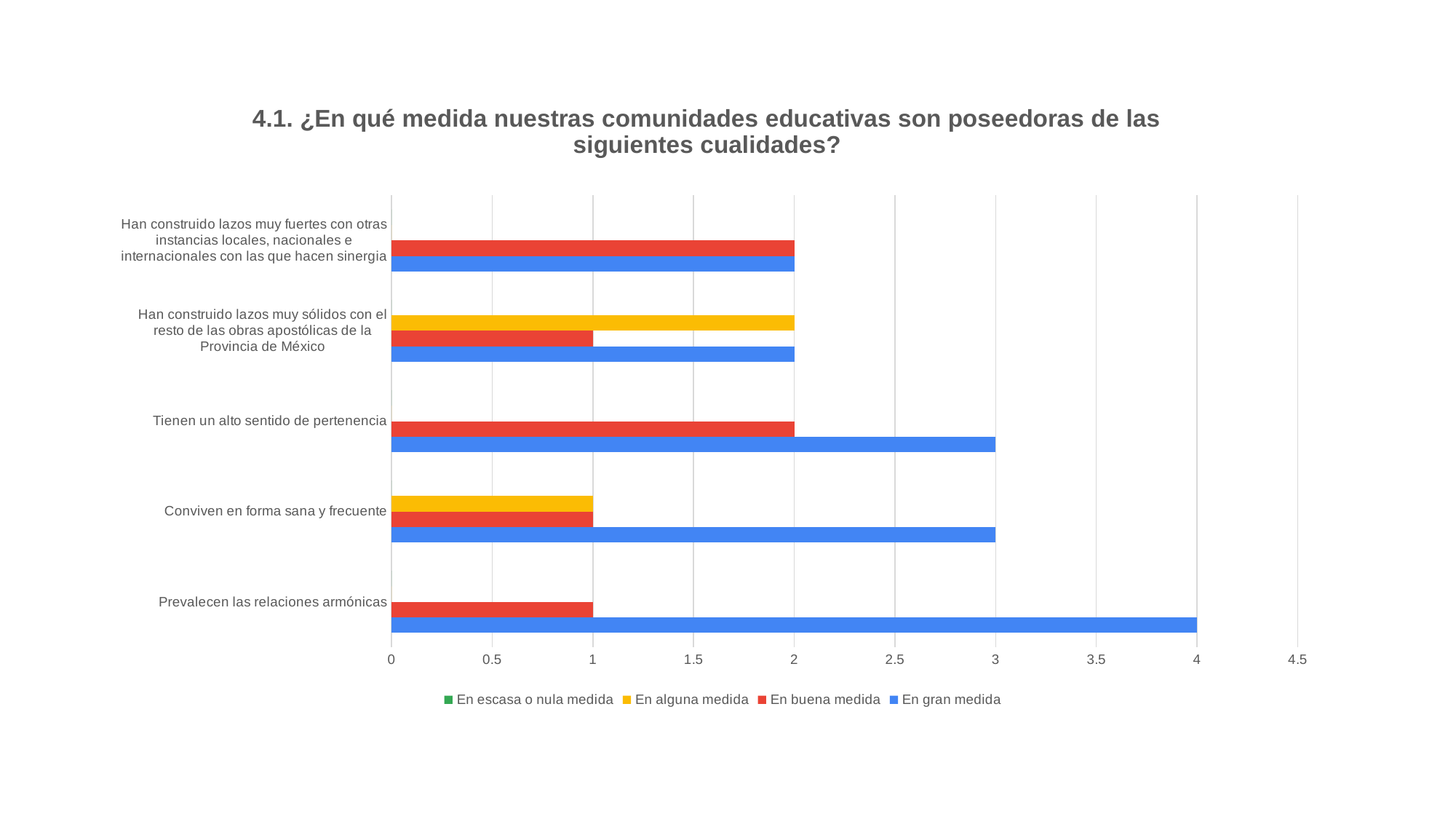
What kind of chart is shown on the slide? Bar chart Which colour represents the series "En buena medida" in the legend? Red Is the "En gran medida" value for "Prevalecen las relaciones armónicas" greater or less than 3.5? greater How many categories are shown on the vertical axis? 5 What is the value of "En gran medida" for "Tienen un alto sentido de pertenencia"? 3 What is the difference between the "En gran medida" values for "Prevalecen las relaciones armónicas" and "Conviven en forma sana y frecuente"? 1 What is the value of "En alguna medida" for "Han construido lazos muy sólidos con el resto de las obras apostólicas de la Provincia de México"? 2 How many series does the legend list? 4 What is the value of "En buena medida" for "Conviven en forma sana y frecuente"? 1 For "Tienen un alto sentido de pertenencia", which is larger: "En gran medida" or "En buena medida"? En gran medida What is the value of "En gran medida" for "Prevalecen las relaciones armónicas"? 4 Which category has the highest value for "En gran medida"? Prevalecen las relaciones armónicas